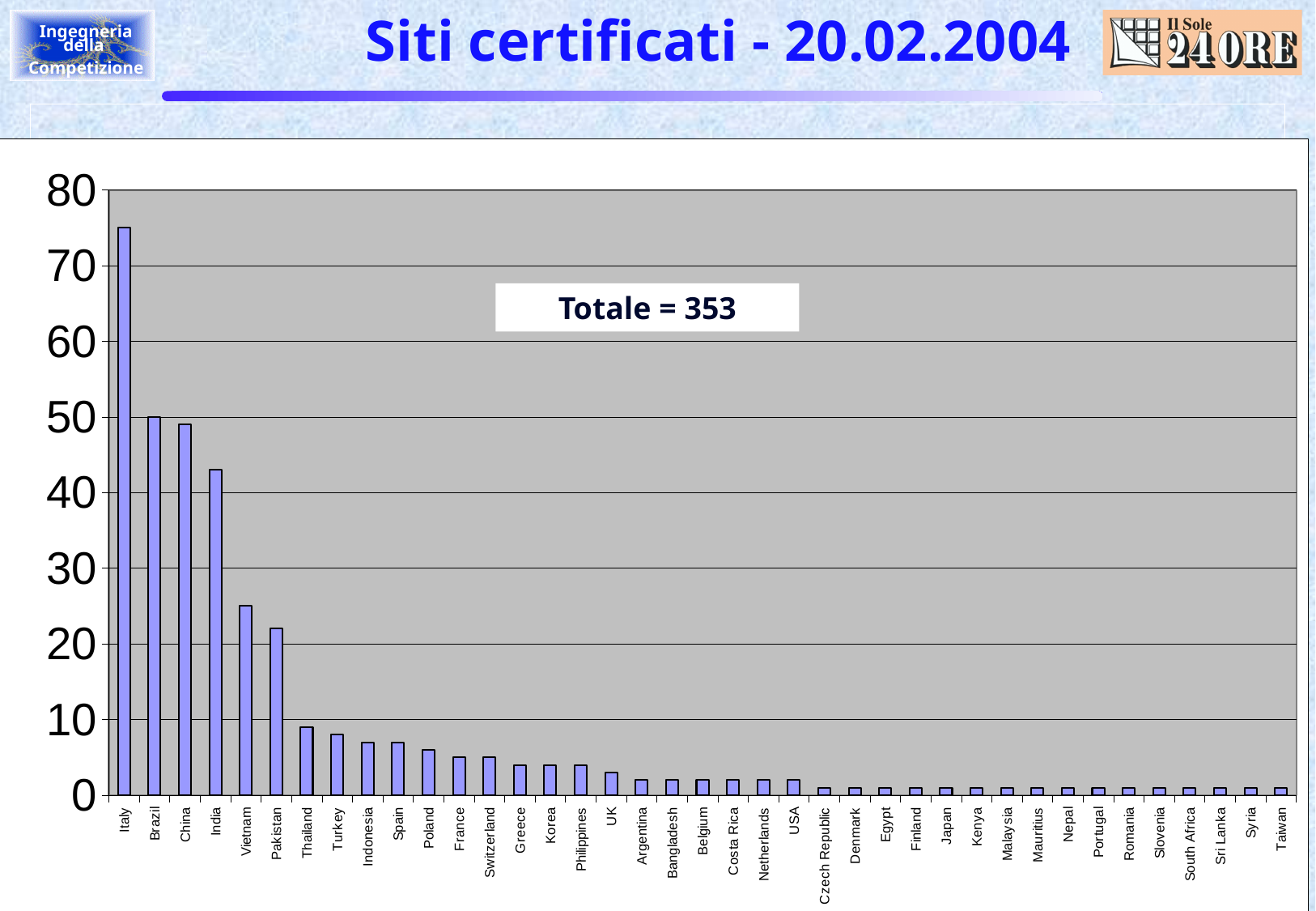
Is the value for Thailand greater or less than 10? less Which has a larger value, Italy or Brazil? Italy Which country has the highest bar in the chart? Italy Do the bar values rise or fall moving from left to right along the x axis? fall Is the value for Vietnam greater or less than 20? greater What kind of chart is shown on the slide? bar chart Is the value for China greater or less than 60? less Which has a larger value, India or Vietnam? India What total is stated in the text box inside the chart? Totale = 353 How many countries are shown on the x axis of the chart? 39